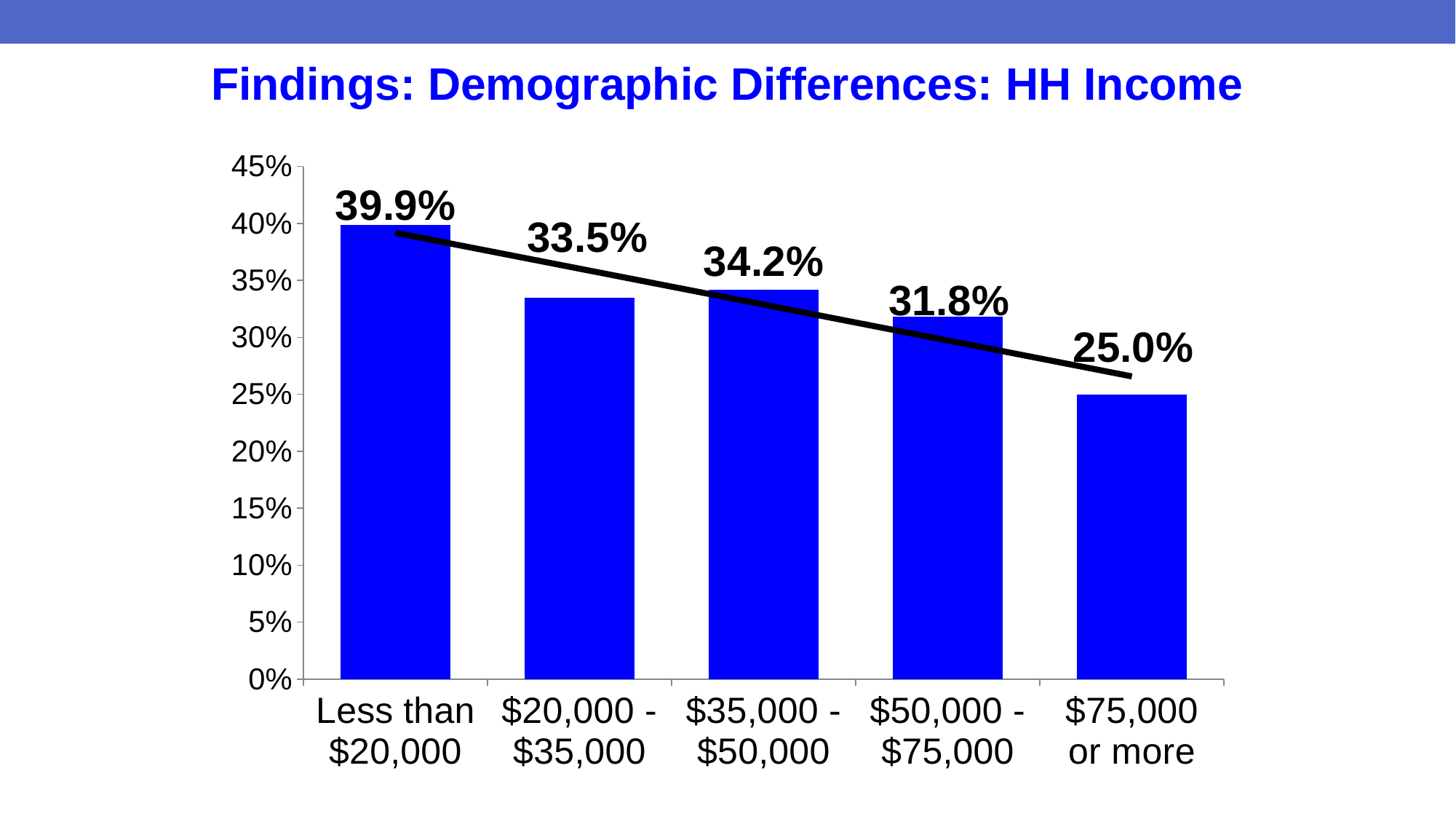
What is the value for the 'Less than $20,000' income group? 39.9% What is the difference between the values for '$20,000 - $35,000' and '$50,000 - $75,000'? 1.7% Is the value for '$50,000 - $75,000' greater or less than 30%? greater What is the title of the slide? Findings: Demographic Differences: HH Income What kind of chart is shown on the slide? bar chart How many income groups are shown on the chart? 5 What is the difference between the values for 'Less than $20,000' and '$75,000 or more'? 14.9% What is the value for the '$75,000 or more' income group? 25.0% What is the value for the '$35,000 - $50,000' income group? 34.2% Which is larger, the value for '$20,000 - $35,000' or '$35,000 - $50,000'? $35,000 - $50,000 Which income group has the lowest value? $75,000 or more Which income group has the highest value? Less than $20,000